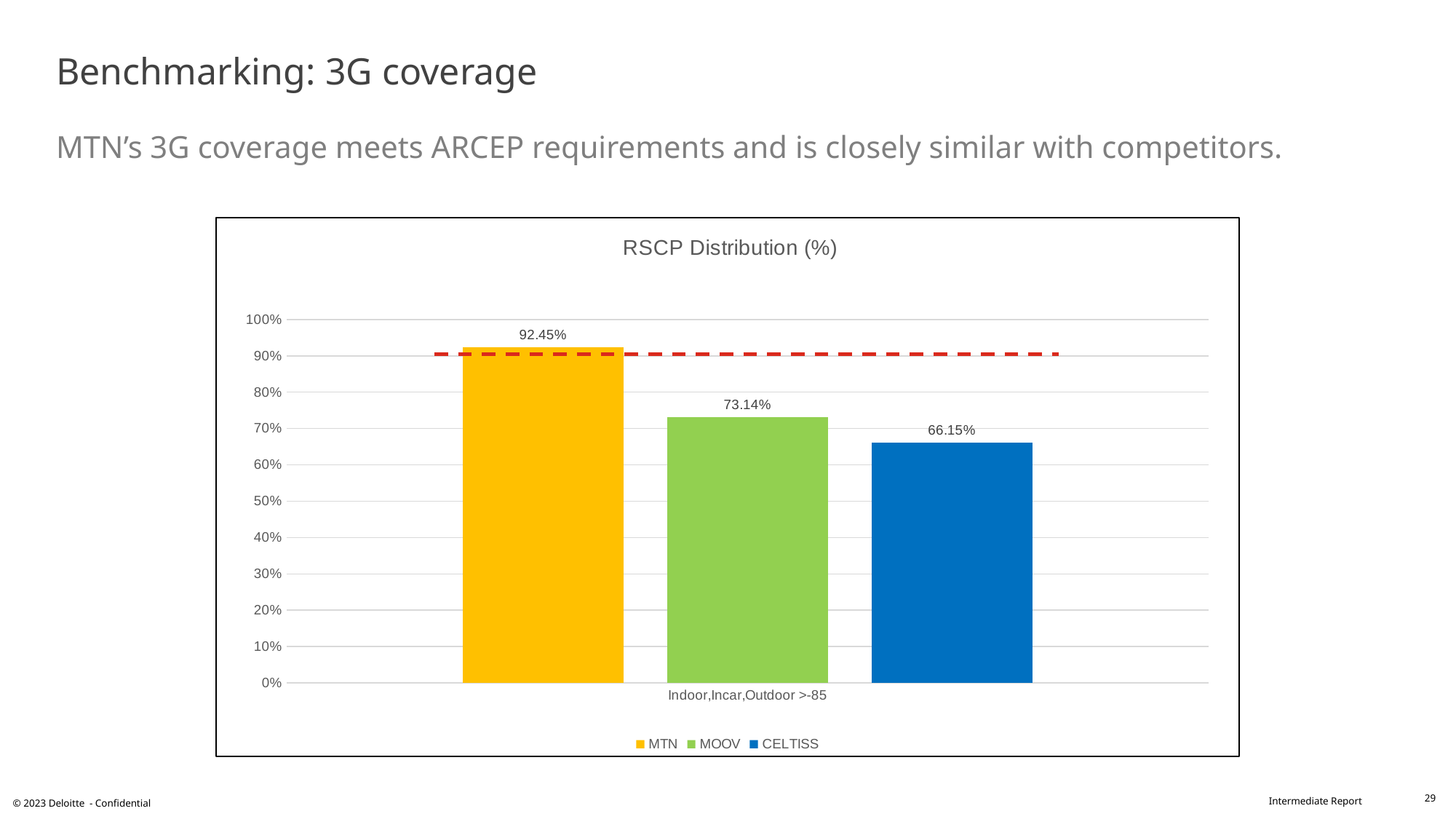
What is the RSCP Distribution value for MOOV? 73.14% Which operator has the lowest RSCP Distribution value? CELTISS What is the difference between MOOV's and CELTISS's RSCP Distribution values? 6.99% What kind of chart is shown on the slide? Bar chart Which is larger, the value for MOOV or the value for CELTISS? MOOV What is the title of the chart? RSCP Distribution (%) Is the value for MTN greater or less than 90%? greater What is the difference between MTN's and MOOV's RSCP Distribution values? 19.31% Which operator has the highest RSCP Distribution value? MTN What is the RSCP Distribution value for MTN? 92.45% What is the RSCP Distribution value for CELTISS? 66.15% How many series does the legend list? 3